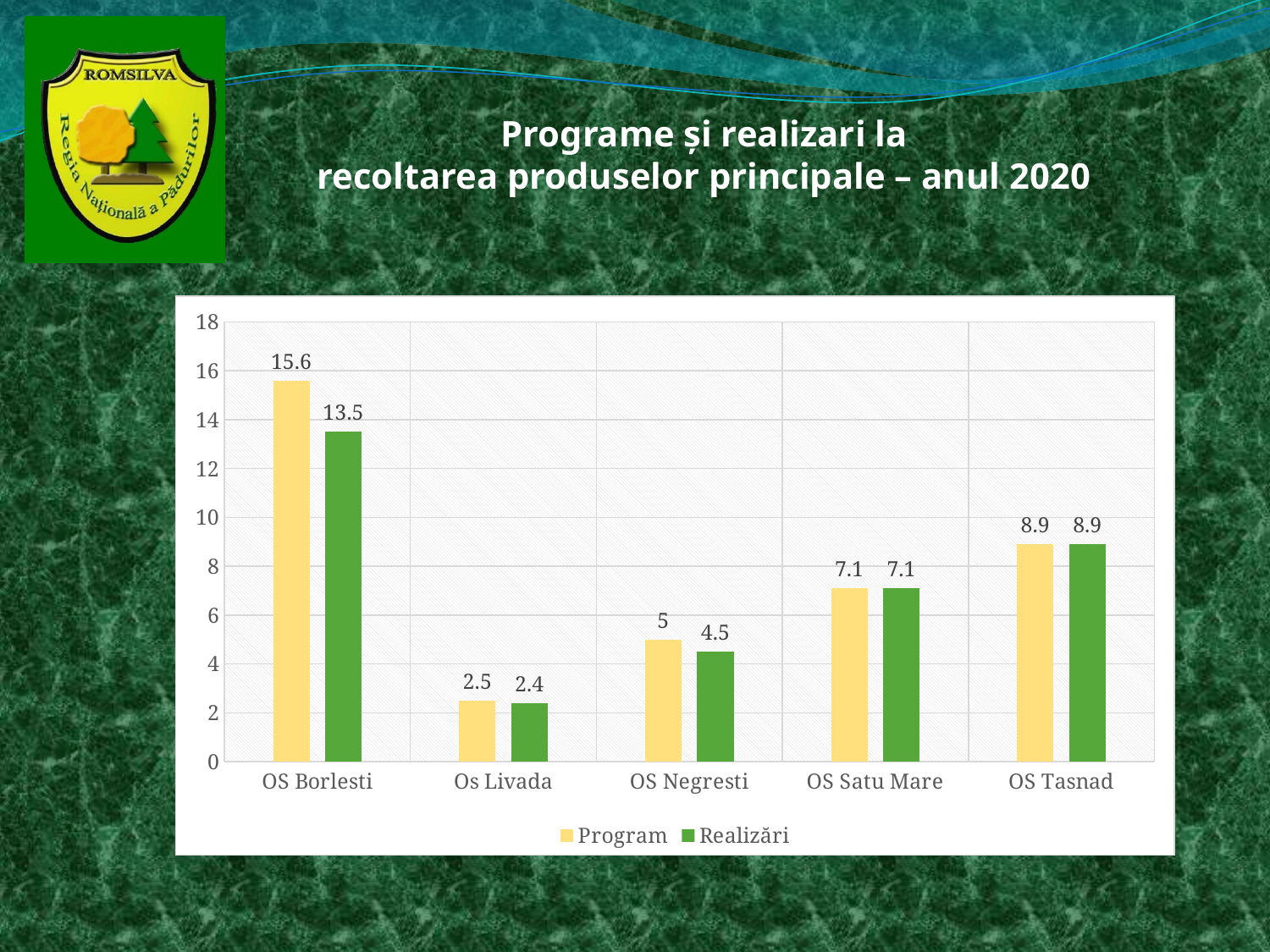
Is the Program value for OS Tasnad greater or less than 10? less What is the Realizări value for Os Livada? 2.4 Which category has the highest Program value? OS Borlesti How many categories are shown on the x axis? 5 Which category has the lowest Realizări value? Os Livada What kind of chart is shown on the slide? bar chart What is the Program value for OS Borlesti? 15.6 What is the difference between the Program and Realizări values for OS Borlesti? 2.1 Which is larger for OS Negresti, the Program value or the Realizări value? Program What is the Realizări value for OS Negresti? 4.5 How many series does the legend list? 2 What colour are the Realizări bars? green